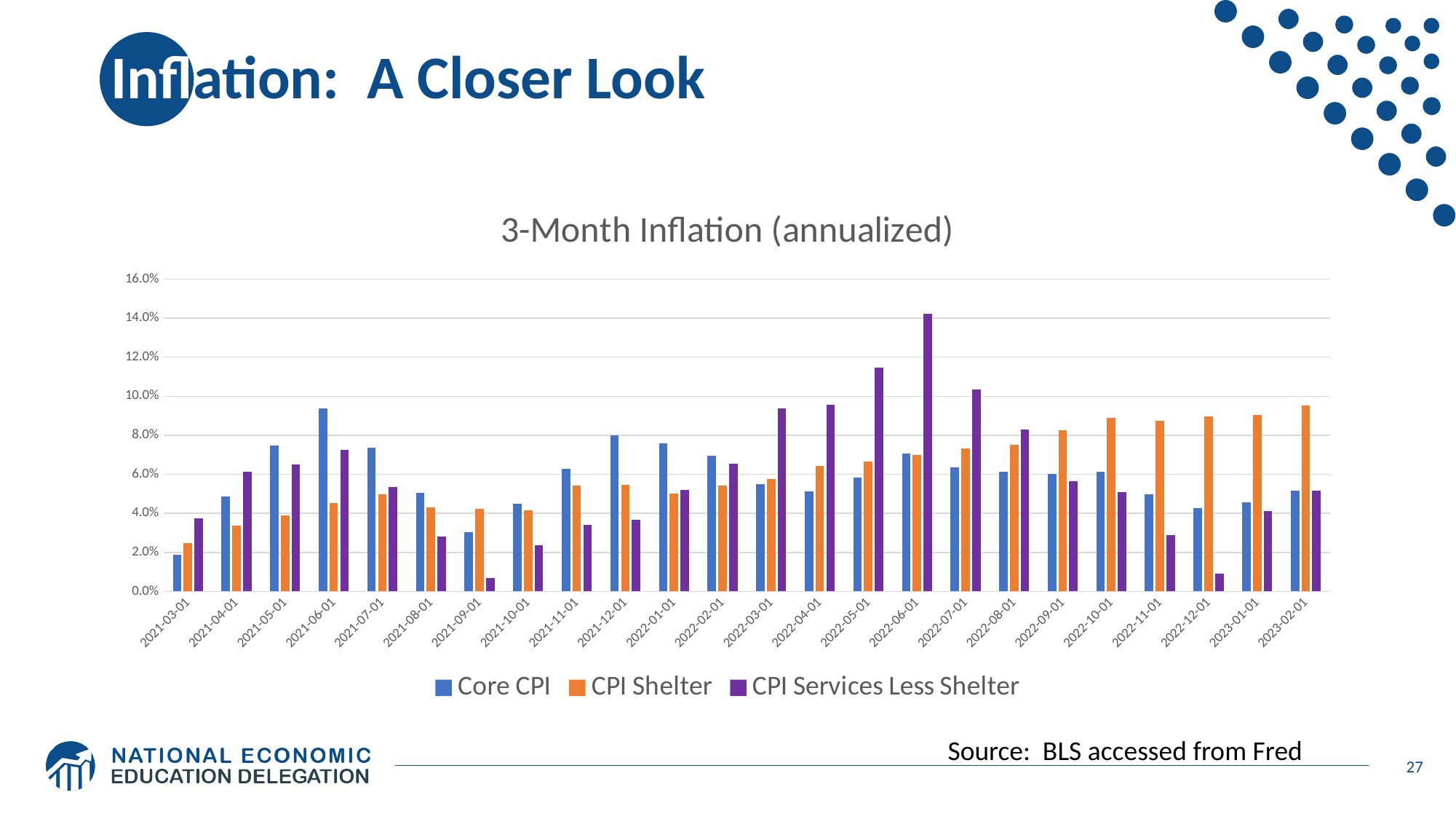
In 2023-02-01, which is larger: Core CPI or CPI Shelter? CPI Shelter How many series does the legend list? 3 Which month has the highest value for CPI Services Less Shelter? 2022-06-01 How many monthly categories are shown on the x axis? 24 Is the value for Core CPI in 2021-06-01 greater or less than 8.0%? greater In 2022-05-01, which is larger: Core CPI or CPI Services Less Shelter? CPI Services Less Shelter What kind of chart is shown on the slide? Bar chart Which month has the lowest value for Core CPI? 2021-03-01 What is the title of the chart? 3-Month Inflation (annualized) Is the value for CPI Services Less Shelter in 2022-06-01 greater or less than 12.0%? greater Which month has the highest value for Core CPI? 2021-06-01 Which month has the lowest value for CPI Services Less Shelter? 2021-09-01